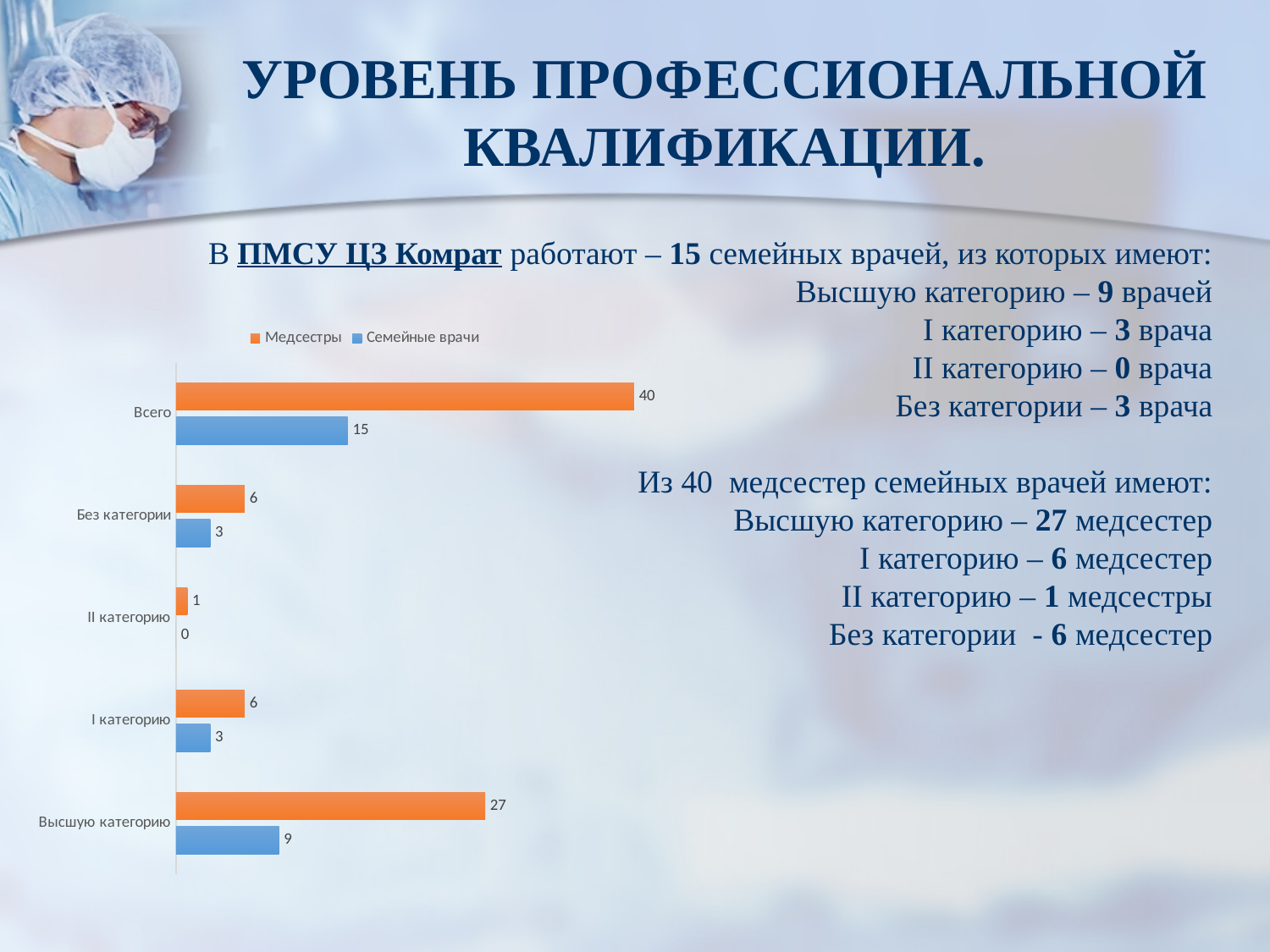
Which is larger in the I категорию category: Медсестры or Семейные врачи? Медсестры How many categories are shown on the chart? 5 What is the difference between Медсестры and Семейные врачи in the Высшую категорию category? 18 What type of chart is shown on the slide? bar chart How many series does the chart legend list? 2 Which category has the lowest value for Семейные врачи? II категорию What is the value for Медсестры in the Без категории category? 6 What is the value for Медсестры in the Высшую категорию category? 27 Which category has the highest value for Медсестры? Всего What is the value for Семейные врачи in the Всего category? 15 Which series is shown in orange in the chart? Медсестры What is the value for Семейные врачи in the II категорию category? 0